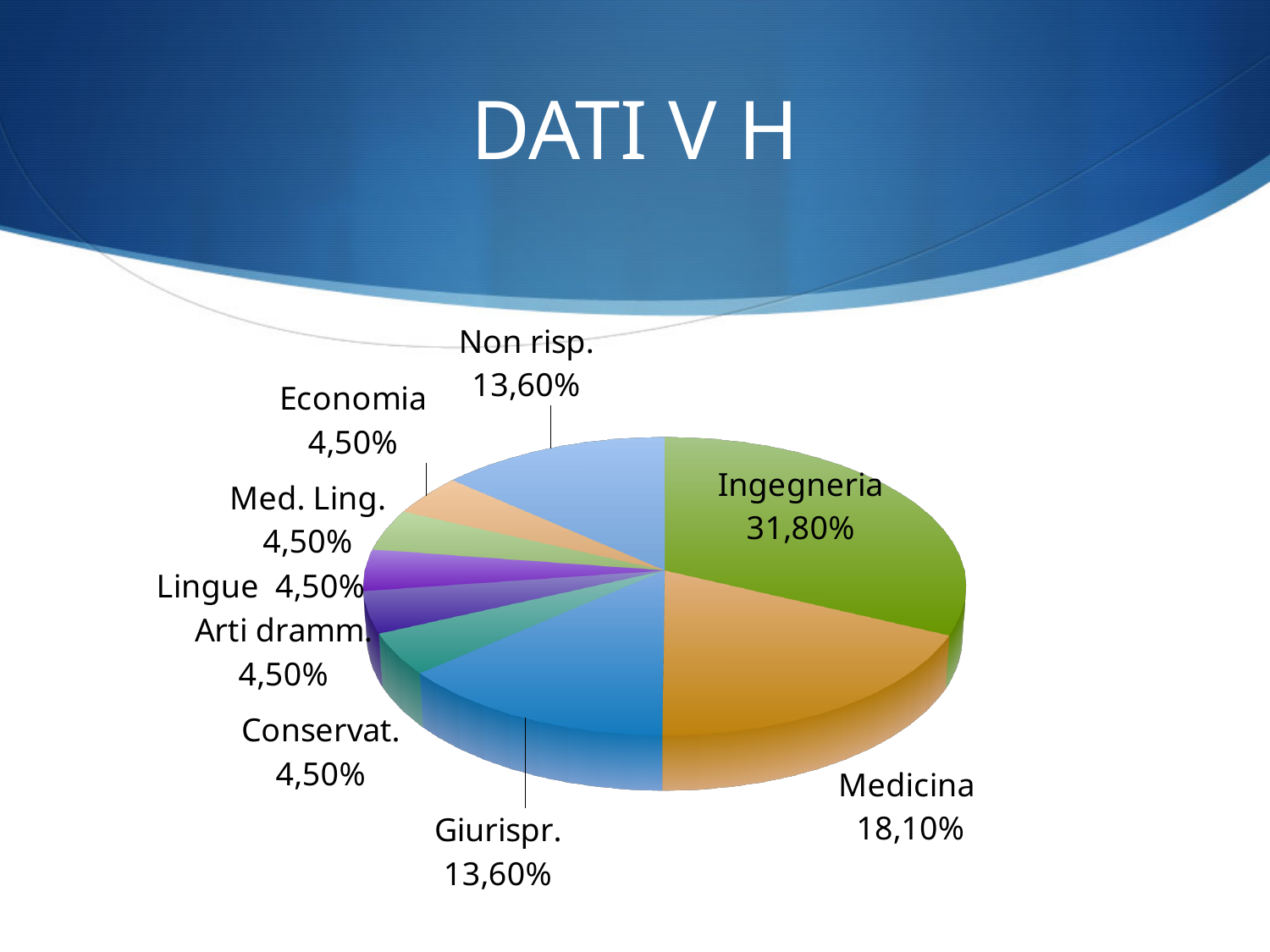
What is the value for Non risp.? 13,60% How many slices does the pie chart have? 9 What is the value for Medicina? 18,10% Which category has the largest slice of the pie? Ingegneria What is the value for Economia? 4,50% What is the value for Giurispr.? 13,60% What is the difference between the values for Medicina and Giurispr.? 4,50% What is the difference between the values for Ingegneria and Medicina? 13,70% What is the title of the slide containing the chart? DATI V H What is the value for Ingegneria? 31,80% Which is larger, the value for Medicina or the value for Non risp.? Medicina What type of chart is shown on the slide? pie chart